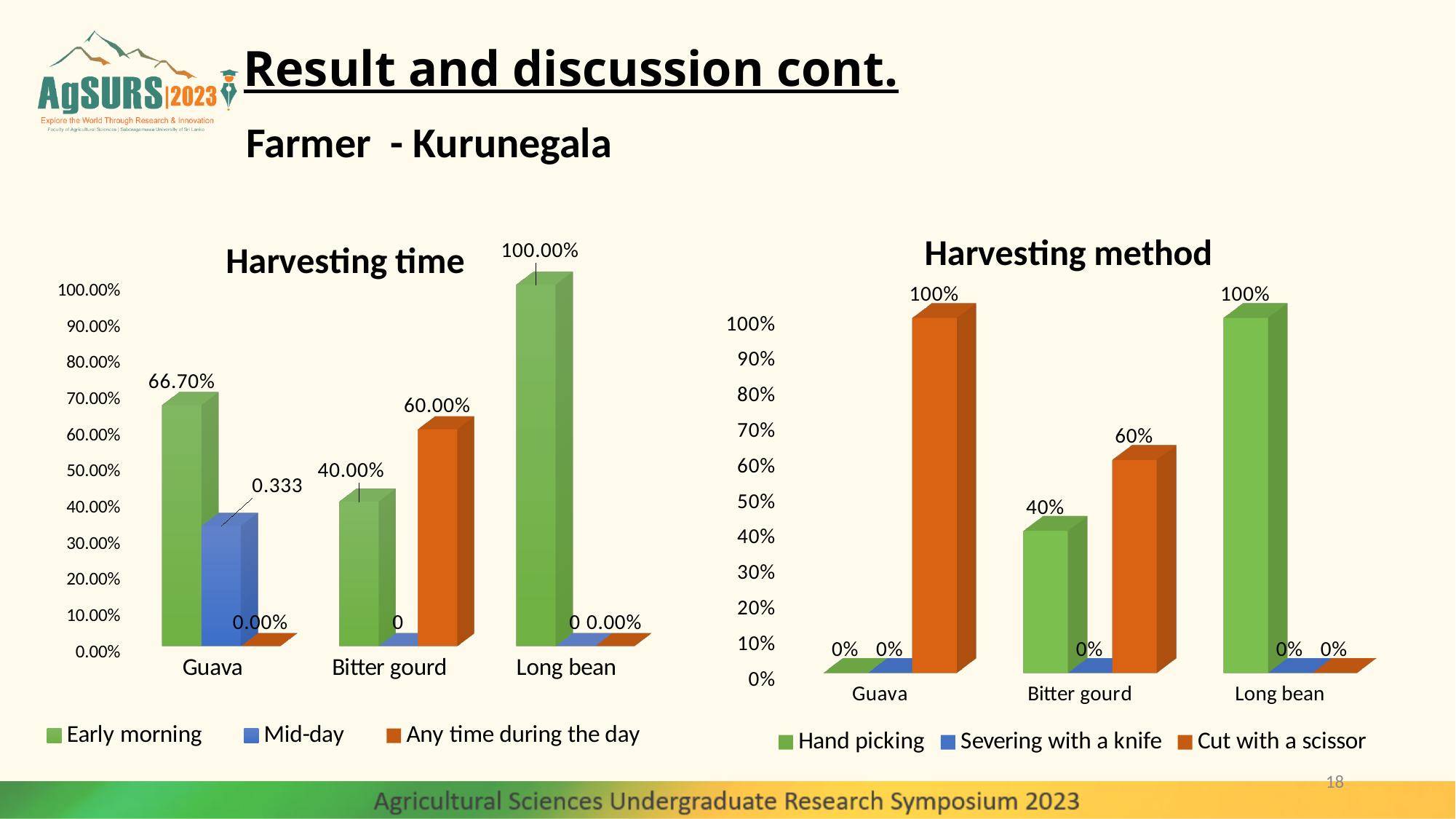
In the Harvesting time chart, how many series does the legend list? 3 In the Harvesting time chart, what is the value for Any time during the day for Bitter gourd? 60.00% In the Harvesting method chart, what is the value for Cut with a scissor for Guava? 100% In the Harvesting time chart, what is the value for Early morning for Long bean? 100.00% In the Harvesting method chart, how many categories are shown on the x axis? 3 In the Harvesting method chart, what is the value for Hand picking for Bitter gourd? 40% What kind of chart is the Harvesting method chart? Bar chart In the Harvesting method chart, what is the difference between Cut with a scissor and Hand picking for Bitter gourd? 20% In the Harvesting time chart, what is the value for Early morning for Guava? 66.70% In the Harvesting method chart, which is larger for Bitter gourd: Hand picking or Cut with a scissor? Cut with a scissor In the Harvesting time chart, what is the difference between the Early morning values for Guava and Bitter gourd? 26.70% In the Harvesting time chart, which category has the highest Early morning value? Long bean